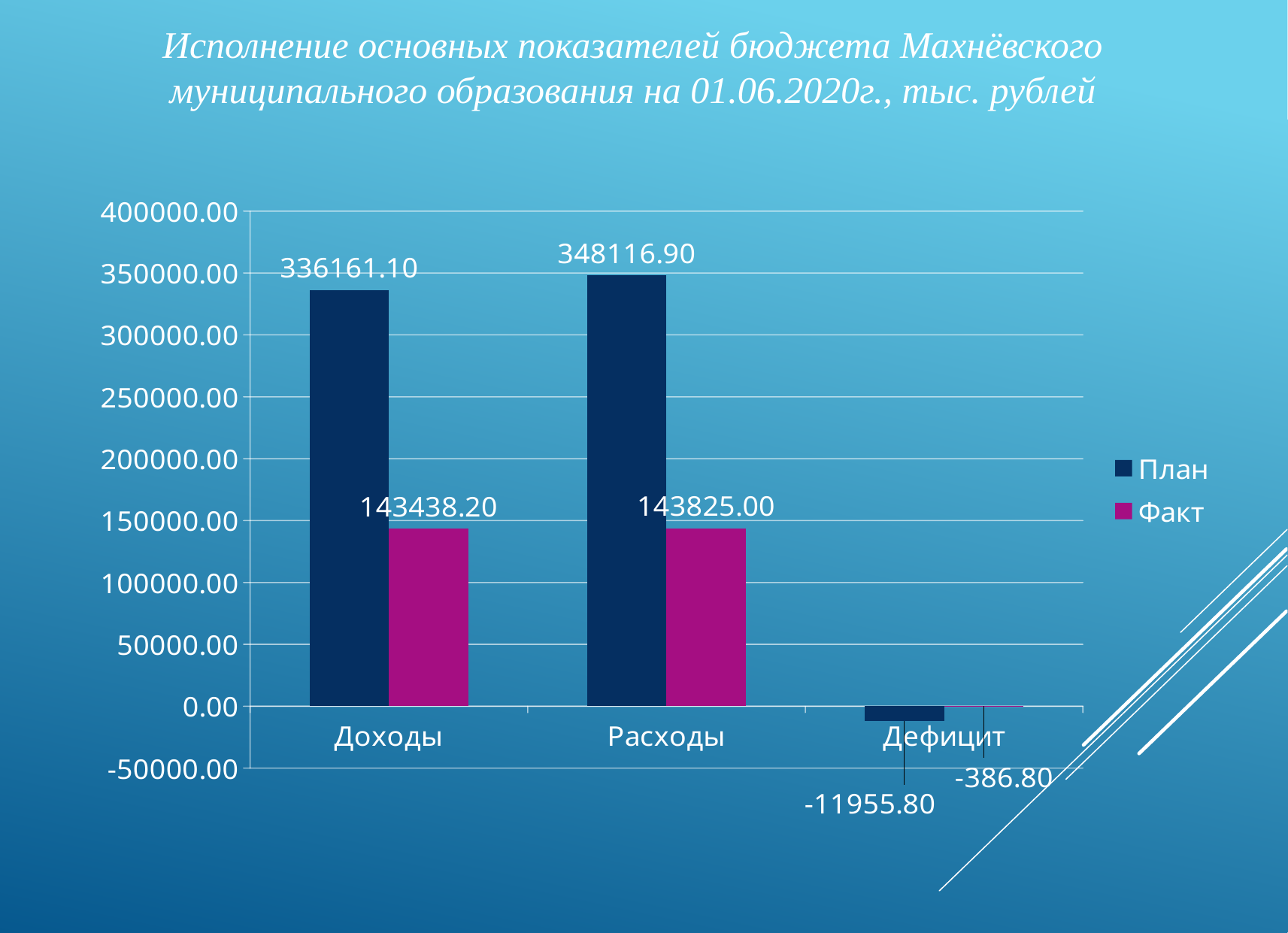
What is the difference between the План and Факт values for Доходы? 192722.90 What is the План value for Доходы? 336161.10 Which is larger for Расходы, the План value or the Факт value? План What is the Факт value for Дефицит? -386.80 What is the difference between the План values for Расходы and Доходы? 11955.80 How many categories are shown on the x axis? 3 Which category has the highest План value? Расходы Which category has the lowest Факт value? Дефицит What is the Факт value for Расходы? 143825.00 What is the План value for Дефицит? -11955.80 What kind of chart is shown on the slide? Bar chart How many series does the legend list? 2